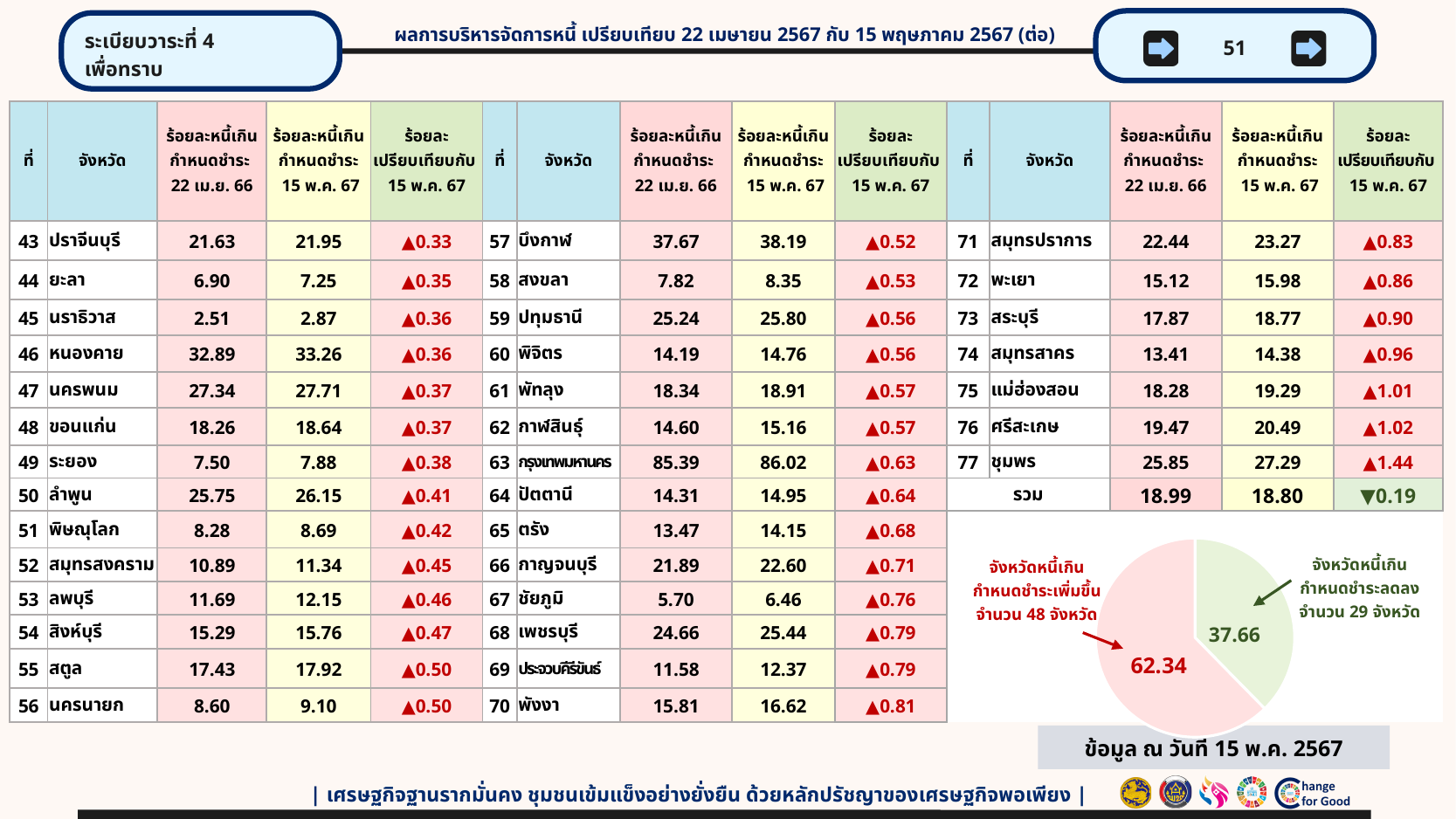
Which slice of the pie chart is the largest? จังหวัดหนี้เกินกำหนดชำระเพิ่มขึ้น (provinces with increased overdue debt) According to the pie chart labels, how many provinces had increased overdue debt? 48 จังหวัด What is the difference between the two slice values in the pie chart (62.34 and 37.66)? 24.68 What kind of chart is shown at the bottom right of the slide? pie chart How many slices does the pie chart have? 2 In the pie chart, is the value for provinces with increased overdue debt larger or smaller than the value for provinces with decreased overdue debt? larger Which slice of the pie chart is the smallest? จังหวัดหนี้เกินกำหนดชำระลดลง (provinces with decreased overdue debt) What is the total of the two slice values shown in the pie chart? 100 In the pie chart, what value is shown for the slice labelled จังหวัดหนี้เกินกำหนดชำระเพิ่มขึ้น (provinces with increased overdue debt)? 62.34 In the pie chart, what value is shown for the slice labelled จังหวัดหนี้เกินกำหนดชำระลดลง (provinces with decreased overdue debt)? 37.66 What share of the pie does the slice for provinces with decreased overdue debt represent? 37.66 What colour is the larger slice of the pie chart? pink